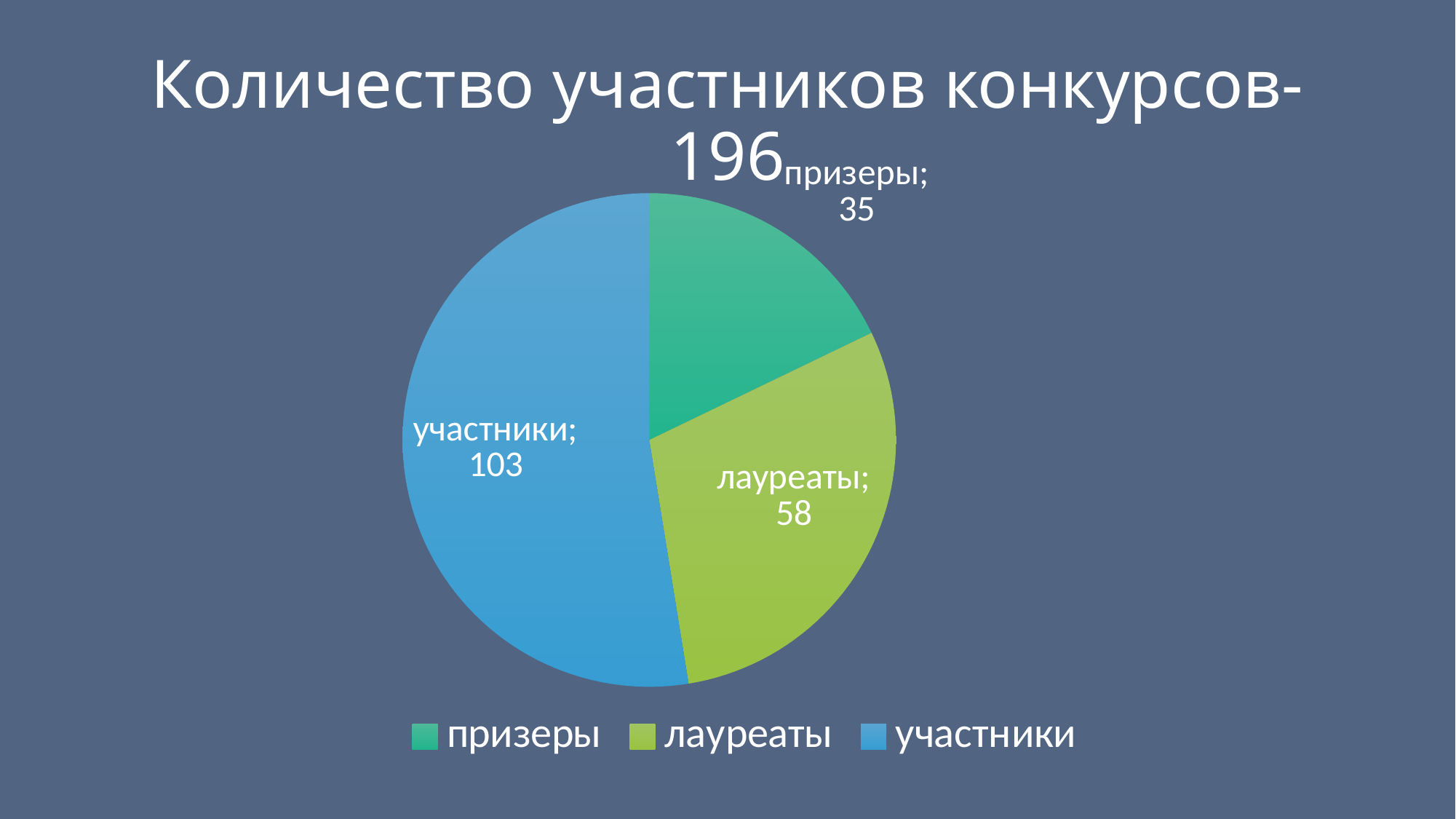
What is the value for призеры? 35 Which category has the smallest slice? призеры What is the difference between лауреаты and призеры? 23 What type of chart is shown on the slide? pie chart Which category has the largest slice? участники How many slices does the pie chart have? 3 What is the value for участники? 103 What colour is the участники slice? blue What is the total of all slices in the pie chart? 196 What is the value for лауреаты? 58 What is the difference between участники and лауреаты? 45 Which is larger, лауреаты or призеры? лауреаты